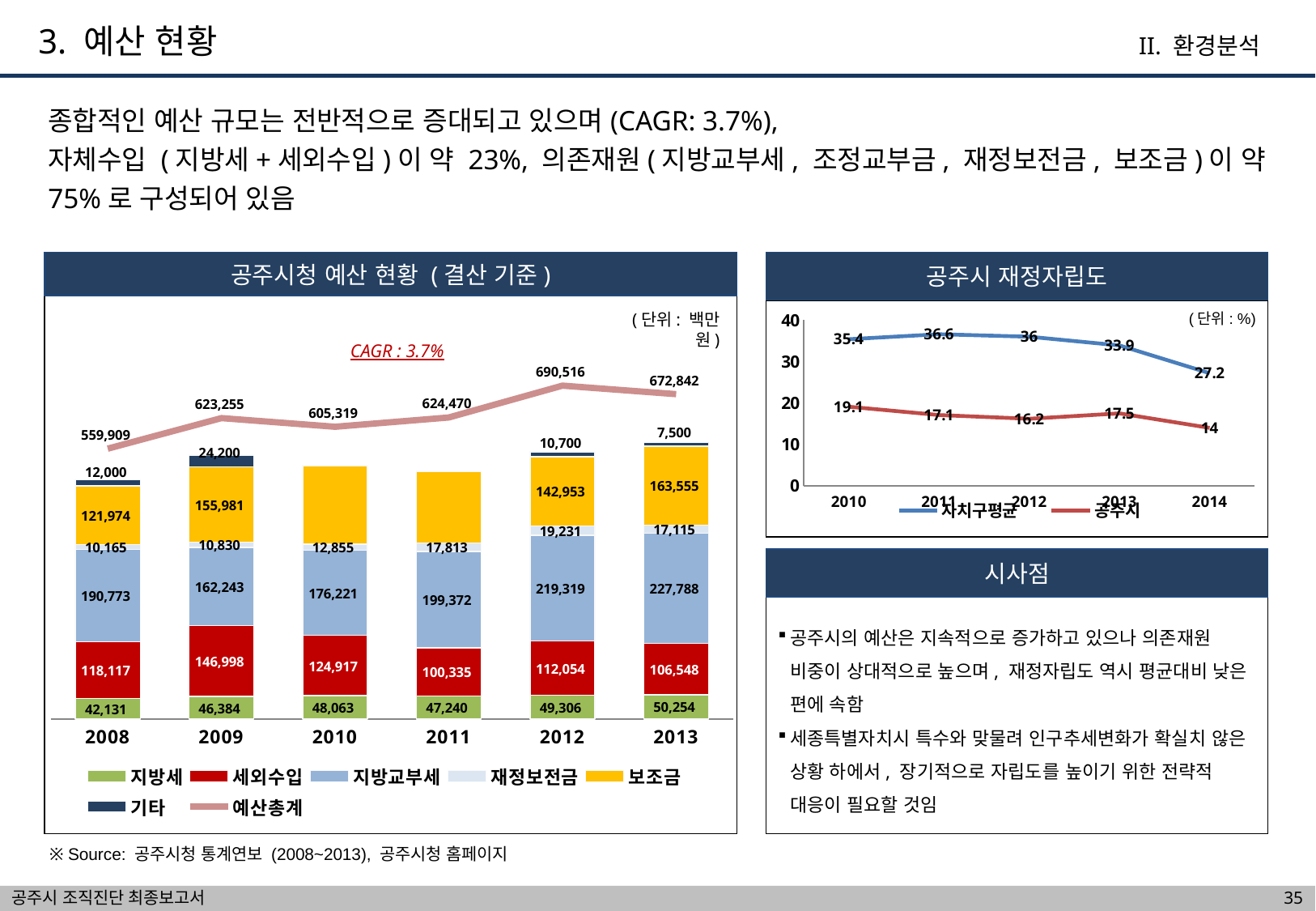
In the 공주시청 예산 현황 (결산 기준) chart, which year has the highest 예산총계? 2012 In the 공주시 재정자립도 chart, does the 자치구평균 series rise or fall from 2011 to 2014? fall In the 공주시청 예산 현황 (결산 기준) chart, what is the 예산총계 value for 2009? 623,255 In the 공주시 재정자립도 chart, what is the difference between 자치구평균 and 공주시 in 2010? 16.3 In the 공주시청 예산 현황 (결산 기준) chart, which year has the larger 세외수입 value, 2009 or 2013? 2009 In the 공주시 재정자립도 chart, what is the 공주시 value for 2014? 14 In the 공주시청 예산 현황 (결산 기준) chart, which year has the lowest 지방세 value? 2008 In the 공주시청 예산 현황 (결산 기준) chart, what is the value of 지방세 for 2013? 50,254 How many series does the legend of the 공주시청 예산 현황 (결산 기준) chart list? 7 What kind of chart is the 공주시 재정자립도 chart? line chart How many years are shown on the x axis of the 공주시청 예산 현황 (결산 기준) chart? 6 In the 공주시청 예산 현황 (결산 기준) chart, what is the difference between the 예산총계 for 2012 and 2013? 17,674